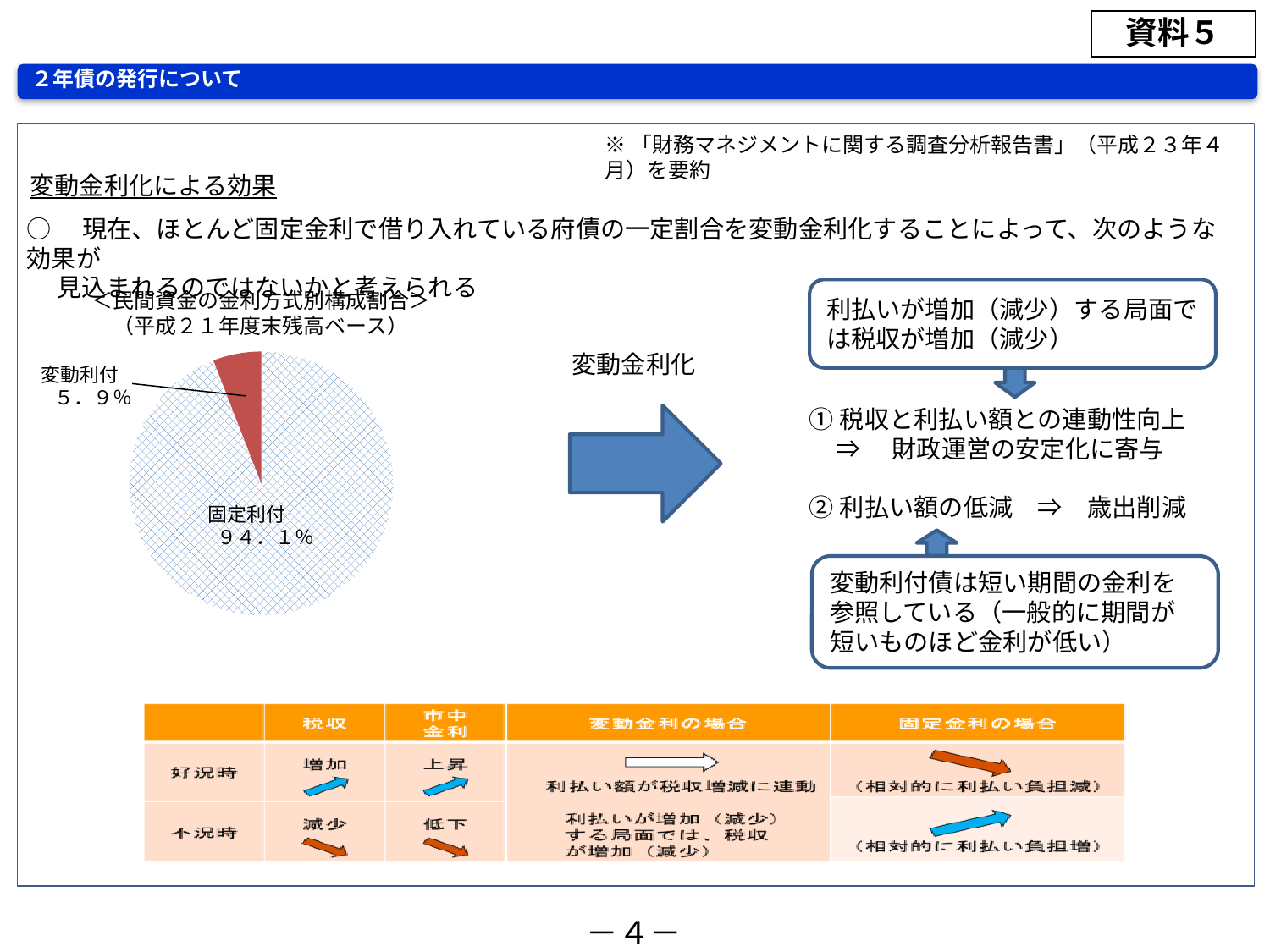
What share of the pie chart is 変動利付? ５．９％ Is the share of 変動利付 in the pie chart greater or less than 10%? less Which category has the largest share in the pie chart? 固定利付 Which category has the smallest share in the pie chart? 変動利付 How many slices does the pie chart have? 2 What share of the pie chart is 固定利付? ９４．１％ Which is larger in the pie chart, 変動利付 or 固定利付? 固定利付 What is the difference in percentage points between 固定利付 and 変動利付 in the pie chart? ８８．２％ What kind of chart is shown on the slide? pie chart What is the title of the pie chart? ＜民間資金の金利方式別構成割合＞（平成２１年度末残高ベース） What colour is the 変動利付 slice in the pie chart? red